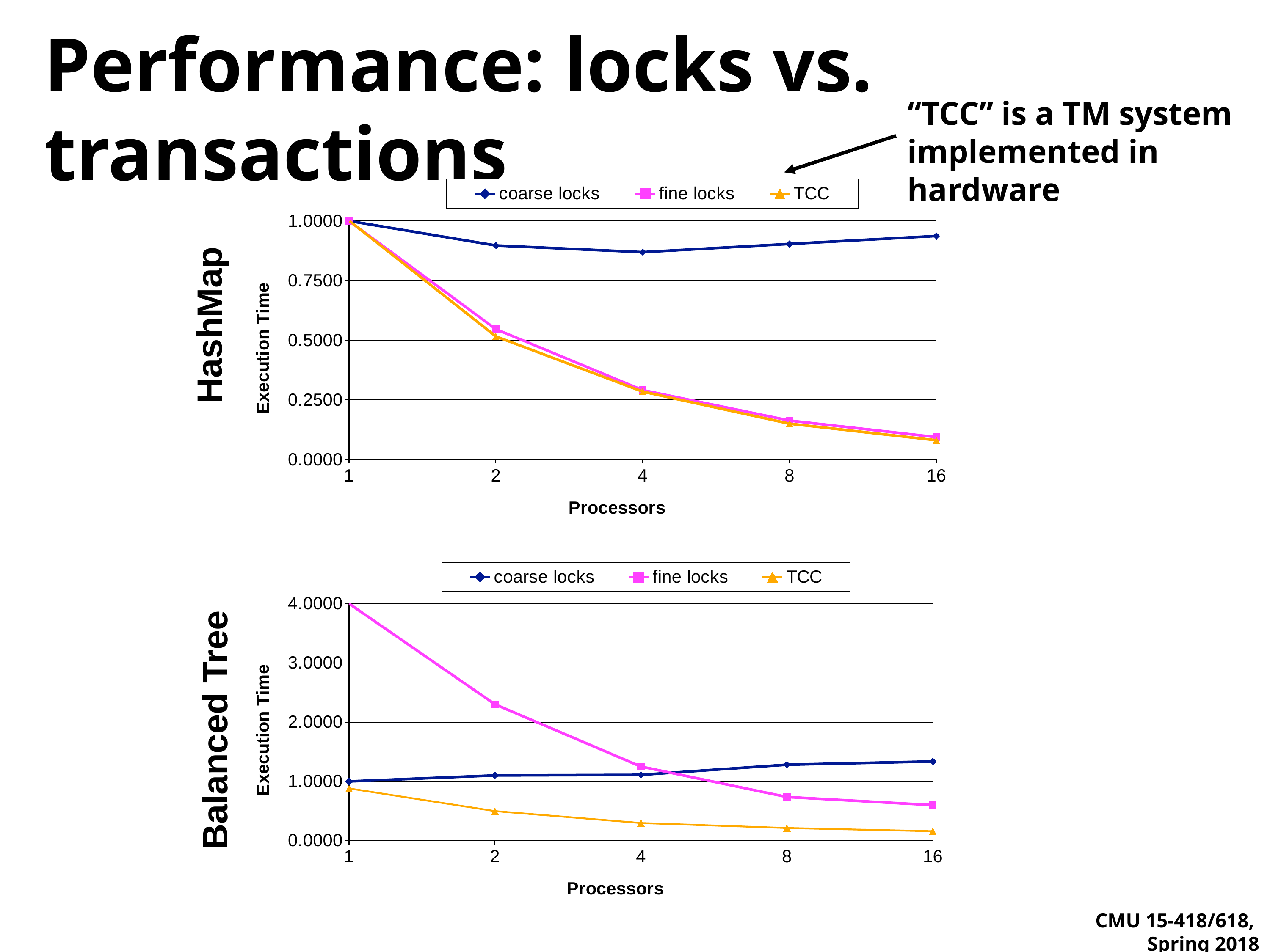
In the HashMap chart, what is the execution time for coarse locks at 1 processor? 1.0000 In the Balanced Tree chart, what is the execution time for fine locks at 1 processor? 4.0000 In the Balanced Tree chart, is the execution time for fine locks at 2 processors greater or less than 2.0000? greater In the Balanced Tree chart, which series has the highest execution time at 16 processors? coarse locks In the Balanced Tree chart, which series has the lowest execution time at 4 processors? TCC In the Balanced Tree chart, what is the execution time for coarse locks at 1 processor? 1.0000 In the HashMap chart, is the execution time for coarse locks at 4 processors greater or less than 0.7500? greater How many series does the legend of the Balanced Tree chart list? 3 In the Balanced Tree chart, does the execution time for coarse locks rise or fall as the number of processors increases? rise How many processor counts are plotted along the x axis of the HashMap chart? 5 What type of chart is the HashMap chart? line chart In the HashMap chart, is the execution time for TCC at 16 processors greater or less than 0.2500? less